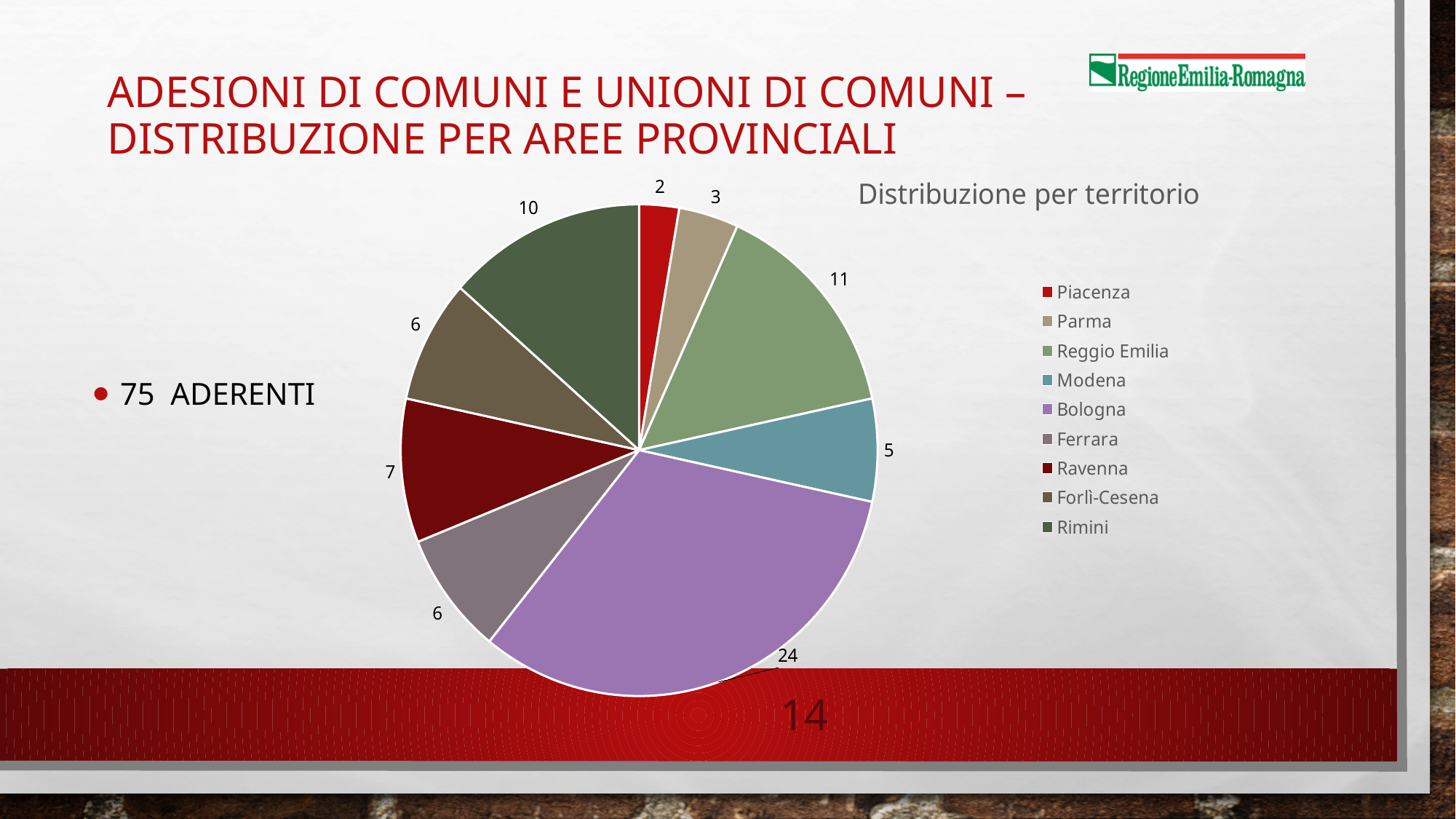
What is the value for Reggio Emilia in the pie chart? 11 What is the difference between the values for Bologna and Reggio Emilia? 13 What type of chart is shown on the slide? pie chart Which is larger, the value for Ravenna or the value for Modena? Ravenna How many provinces are shown in the pie chart? 9 What is the value for Bologna in the pie chart? 24 What is the difference between the values for Rimini and Ravenna? 3 What is the value for Modena in the pie chart? 5 What is the value for Rimini in the pie chart? 10 Which province has the smallest slice of the pie chart? Piacenza What is the title of the chart? Distribuzione per territorio Which province has the largest slice of the pie chart? Bologna